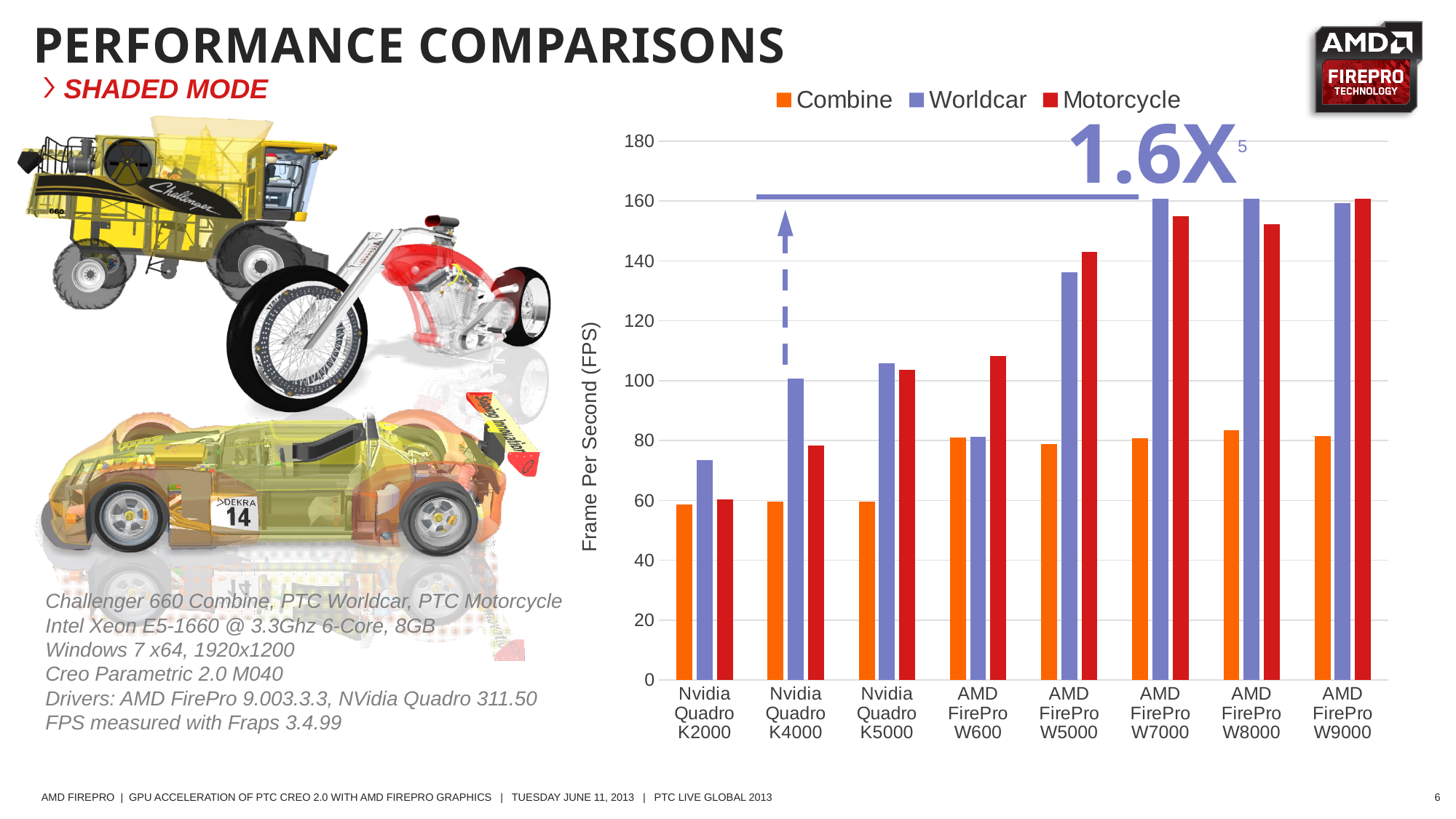
Is the Worldcar value for Nvidia Quadro K4000 greater or less than 80? greater Moving along the x axis from Nvidia Quadro K2000 to AMD FirePro W9000, do the Motorcycle values generally rise or fall? rise Which graphics card has the lowest Worldcar value? Nvidia Quadro K2000 Is the Motorcycle value for AMD FirePro W600 greater or less than 100? greater For AMD FirePro W5000, which is larger: the Motorcycle value or the Combine value? Motorcycle Which graphics card has the lowest Motorcycle value? Nvidia Quadro K2000 How many series does the legend list? 3 What kind of chart is shown on the slide? Bar chart For Nvidia Quadro K4000, which is larger: the Worldcar value or the Combine value? Worldcar Is the Combine value for Nvidia Quadro K5000 greater or less than 80? less What is the label on the y axis of the chart? Frame Per Second (FPS) How many graphics cards are shown along the x axis? 8